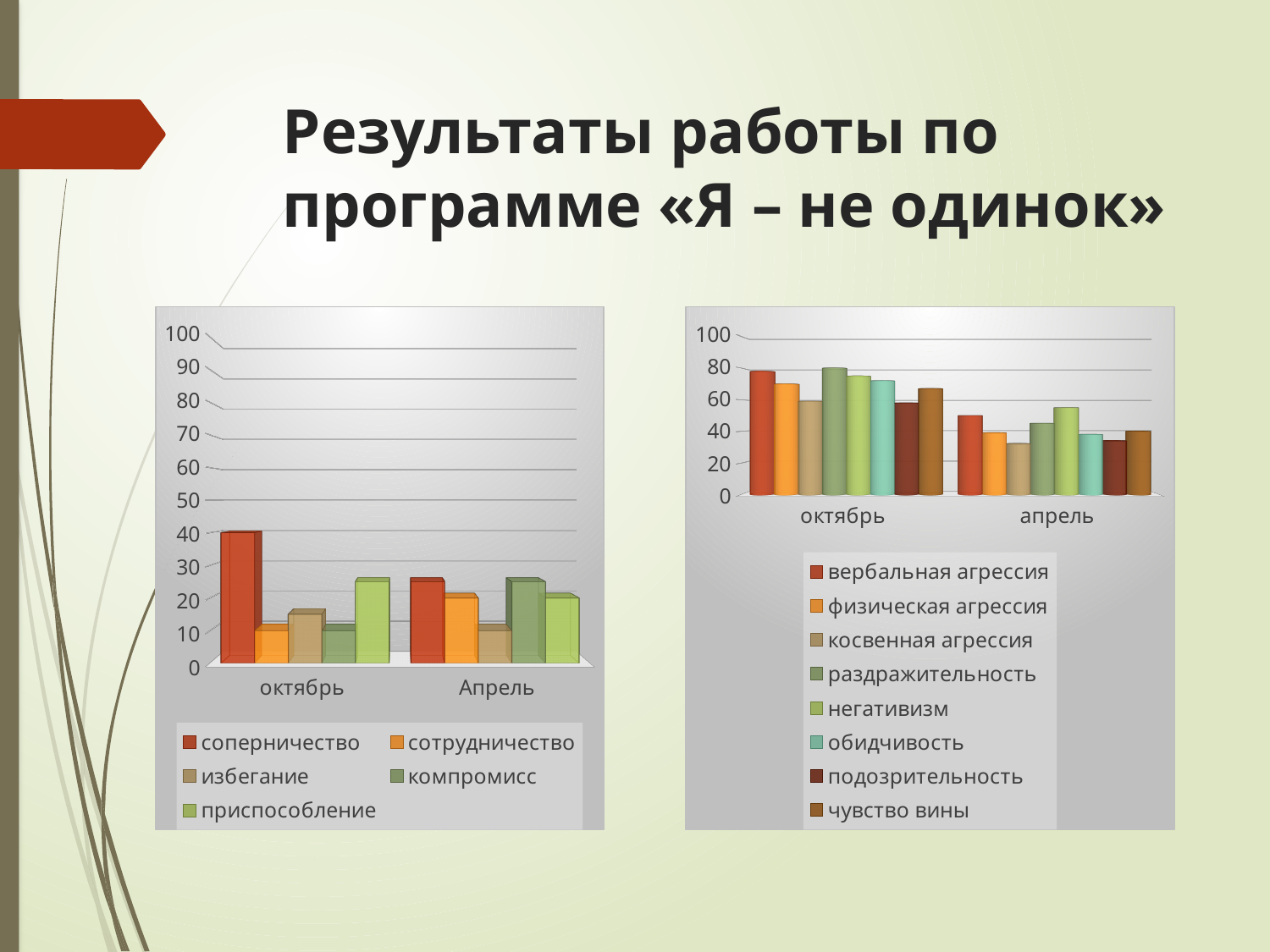
In the left chart, is the value for соперничество in октябрь greater or less than 30? greater What kind of chart is the left chart on the slide? bar chart How many series does the legend of the left chart list? 5 In the left chart, what is the value for соперничество in октябрь? 40 How many series does the legend of the right chart list? 8 In the right chart, which is larger: вербальная агрессия in октябрь or вербальная агрессия in апрель? октябрь In the right chart, is the value for вербальная агрессия in октябрь greater or less than 60? greater In the left chart, is the value for сотрудничество in октябрь greater or less than 20? less In the left chart, does the value for соперничество rise or fall from октябрь to Апрель? fall How many categories are shown on the x axis of the right chart? 2 In the left chart, which series has the highest value in октябрь? соперничество